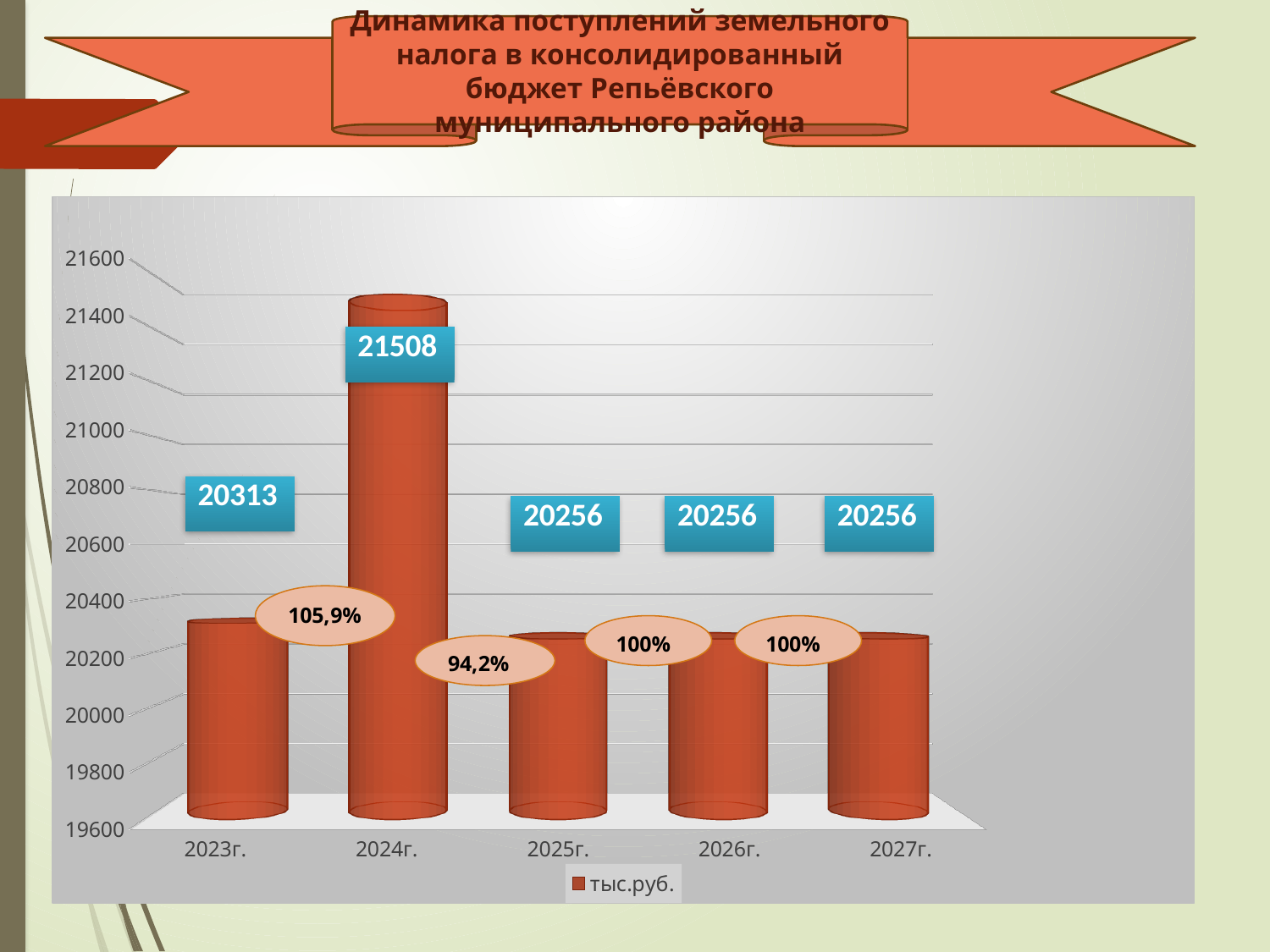
How many series does the legend list? 1 What is the difference between the values for 2024г. and 2023г.? 1195 What is the legend entry of the chart? тыс.руб. What is the value for 2024г.? 21508 What is the value for 2023г.? 20313 What is the difference between the values for 2023г. and 2025г.? 57 Which year has the highest value? 2024г. How many years are shown on the x axis? 5 What kind of chart is shown on the slide? bar chart Is the value for 2024г. greater or less than 21000? greater Which is larger, the value for 2023г. or the value for 2025г.? 2023г. What is the value for 2026г.? 20256